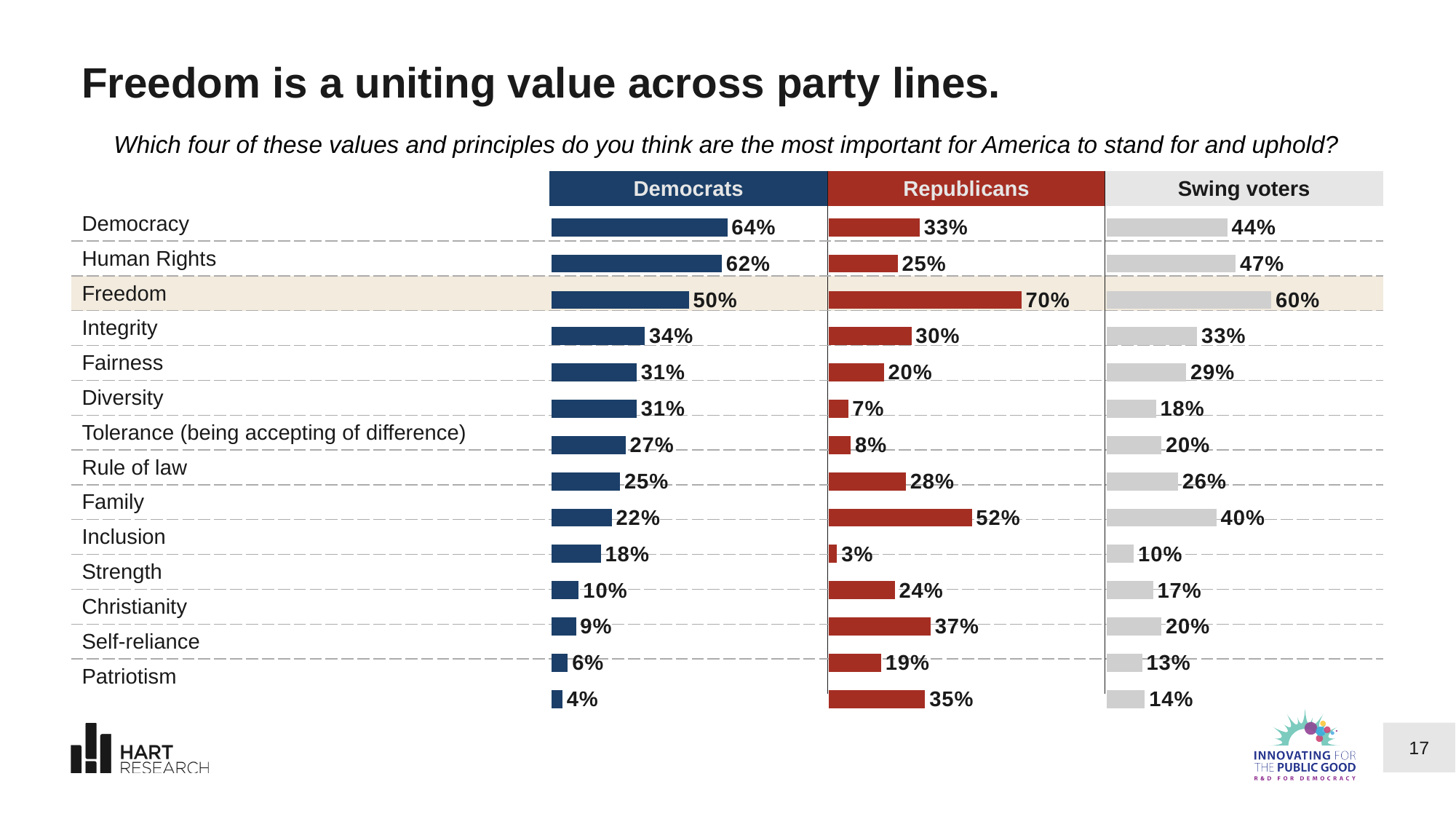
What is the difference between the Republicans and Democrats percentages for Freedom? 20 percentage points In the Democrats chart, which value has the lowest percentage? Patriotism What type of chart is used on this slide? Bar chart In the Swing voters chart, what percentage chose Family? 40% In the Republicans chart, what percentage chose Freedom? 70% In the Democrats chart, what percentage chose Democracy? 64% Which row is highlighted with a shaded background on the slide? Freedom How many values and principles are listed in the charts? 14 In the Republicans chart, what is the difference between Family and Christianity? 15 percentage points In the Swing voters chart, which value has the highest percentage? Freedom In the Republicans chart, which value has the lowest percentage? Inclusion Is the percentage for Patriotism higher among Democrats or Republicans? Republicans